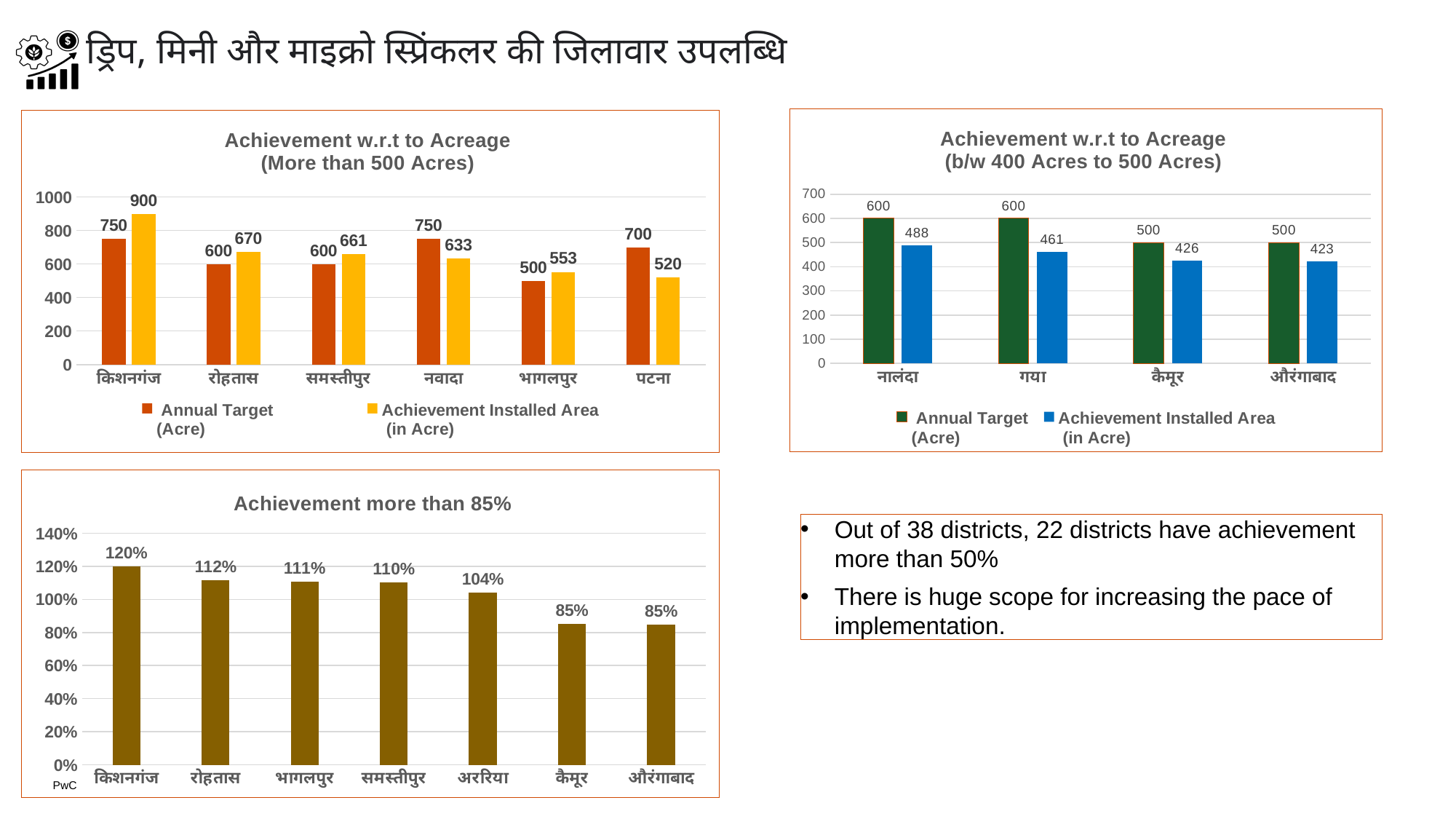
In the chart titled 'Achievement w.r.t to Acreage (More than 500 Acres)', what is the difference between the Annual Target and the Achievement Installed Area for नवादा? 117 In the chart titled 'Achievement w.r.t to Acreage (b/w 400 Acres to 500 Acres)', which district has the highest Achievement Installed Area (in Acre)? नालंदा What kind of chart is the chart titled 'Achievement more than 85%'? bar chart In the chart titled 'Achievement w.r.t to Acreage (More than 500 Acres)', which district has the lowest Achievement Installed Area (in Acre)? पटना In the chart titled 'Achievement w.r.t to Acreage (More than 500 Acres)', how many districts are shown on the x axis? 6 In the chart titled 'Achievement w.r.t to Acreage (b/w 400 Acres to 500 Acres)', how many series does the legend list? 2 In the chart titled 'Achievement w.r.t to Acreage (More than 500 Acres)', what is the Achievement Installed Area (in Acre) for किशनगंज? 900 In the chart titled 'Achievement w.r.t to Acreage (b/w 400 Acres to 500 Acres)', what is the Achievement Installed Area (in Acre) for गया? 461 In the chart titled 'Achievement more than 85%', do the values rise or fall from left to right along the x axis? fall In the chart titled 'Achievement w.r.t to Acreage (b/w 400 Acres to 500 Acres)', what is the difference between the Annual Target and the Achievement Installed Area for कैमूर? 74 In the chart titled 'Achievement w.r.t to Acreage (More than 500 Acres)', what is the Annual Target (Acre) for पटना? 700 In the chart titled 'Achievement more than 85%', what is the value for अररिया? 104%